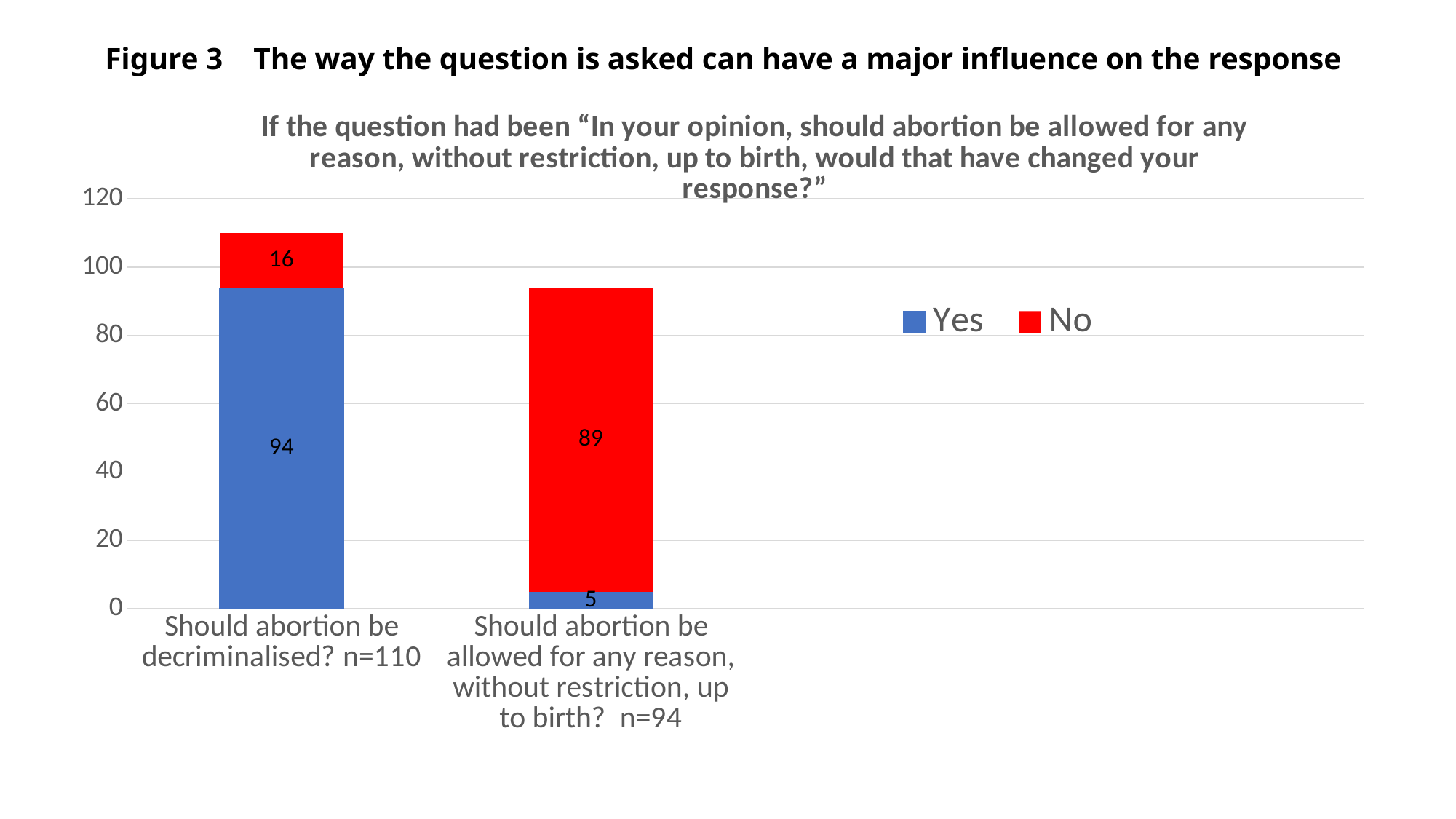
How many series does the legend list? 2 What is the total of the stacked bar for 'Should abortion be decriminalised? n=110'? 110 What is the 'No' value for 'Should abortion be decriminalised? n=110'? 16 What is the 'Yes' value for 'Should abortion be decriminalised? n=110'? 94 Which is larger: the 'Yes' value for 'Should abortion be decriminalised?' or the 'Yes' value for 'Should abortion be allowed for any reason, without restriction, up to birth?'? Should abortion be decriminalised? What is the difference between the 'No' values for the two questions? 73 What is the total of the stacked bar for 'Should abortion be allowed for any reason, without restriction, up to birth? n=94'? 94 What is the 'No' value for 'Should abortion be allowed for any reason, without restriction, up to birth? n=94'? 89 Which colour represents the 'No' series in the chart? Red What kind of chart is shown on the slide? Stacked bar chart What is the 'Yes' value for 'Should abortion be allowed for any reason, without restriction, up to birth? n=94'? 5 What is the difference between the 'Yes' and 'No' values for 'Should abortion be decriminalised? n=110'? 78